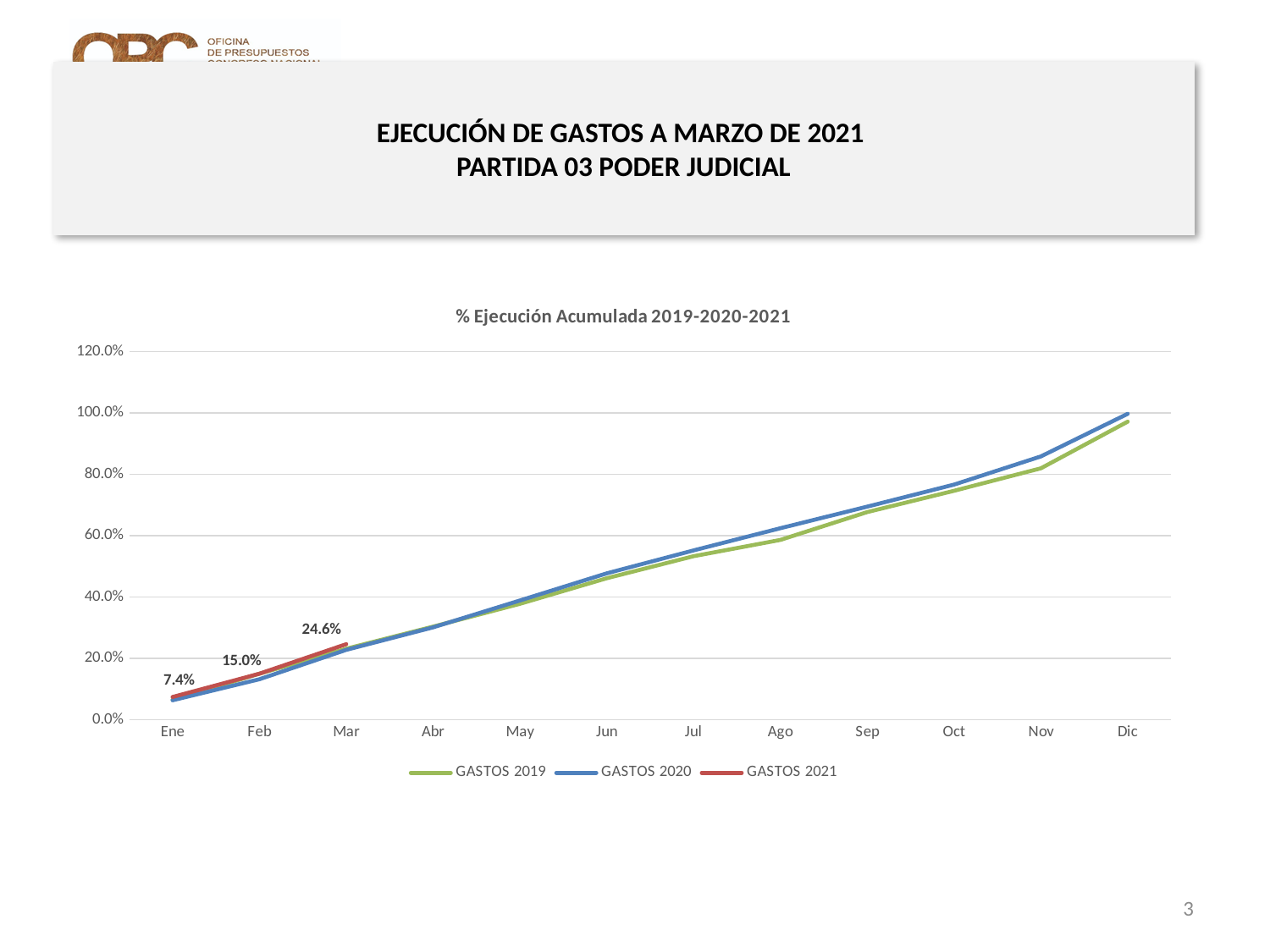
What is the title of the chart? % Ejecución Acumulada 2019-2020-2021 Is the value for GASTOS 2020 in Dic greater or less than 80.0%? greater What kind of chart is shown on the slide? Line chart What is the value for GASTOS 2021 in Ene? 7.4% How many months are shown on the x axis? 12 What is the value for GASTOS 2021 in Feb? 15.0% What is the difference between the GASTOS 2021 values for Mar and Feb? 9.6% How many series does the legend list? 3 What is the value for GASTOS 2021 in Mar? 24.6% Is the value for GASTOS 2019 in Nov greater or less than 100.0%? less Which of the labeled GASTOS 2021 months has the highest value? Mar Do the GASTOS 2020 values rise or fall from Ene to Dic? Rise